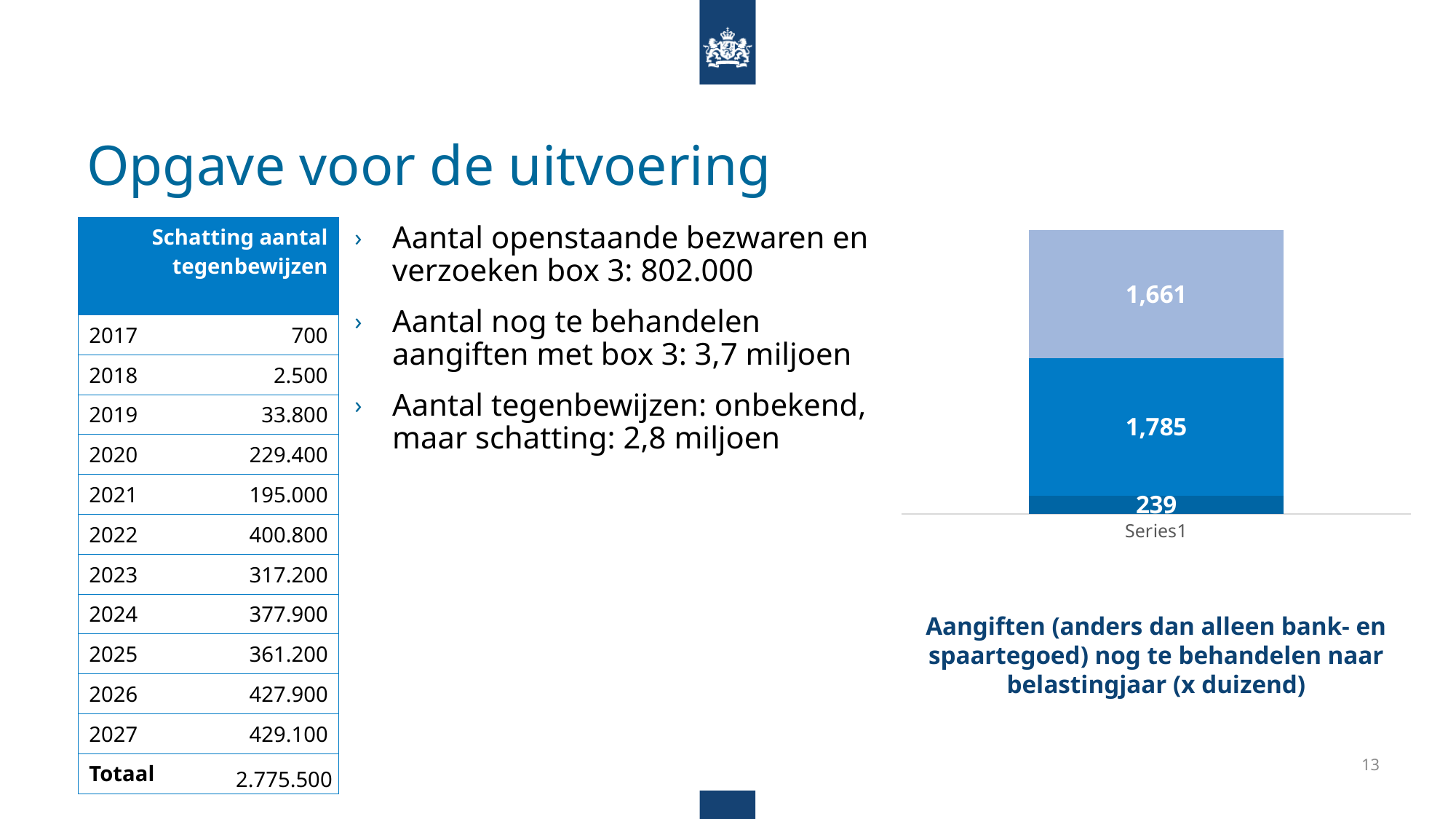
What is the total of the stacked bar in the chart? 3,685 How many bars does the chart on the right of the slide show? 1 Which segment of the stacked bar has the smallest value? the bottom segment (239) What is the value of the middle segment of the stacked bar? 1,785 What label appears on the x axis under the stacked bar? Series1 How many segments make up the stacked bar in the chart? 3 What is the value of the top (lightest blue) segment of the stacked bar? 1,661 What is the value of the bottom (darkest blue) segment of the stacked bar? 239 Which segment of the stacked bar has the largest value? the middle segment (1,785) What kind of chart is shown on the right of the slide? stacked bar chart Is the top segment (1,661) or the bottom segment (239) of the stacked bar larger? the top segment (1,661) What is the difference between the middle segment (1,785) and the top segment (1,661) of the stacked bar? 124